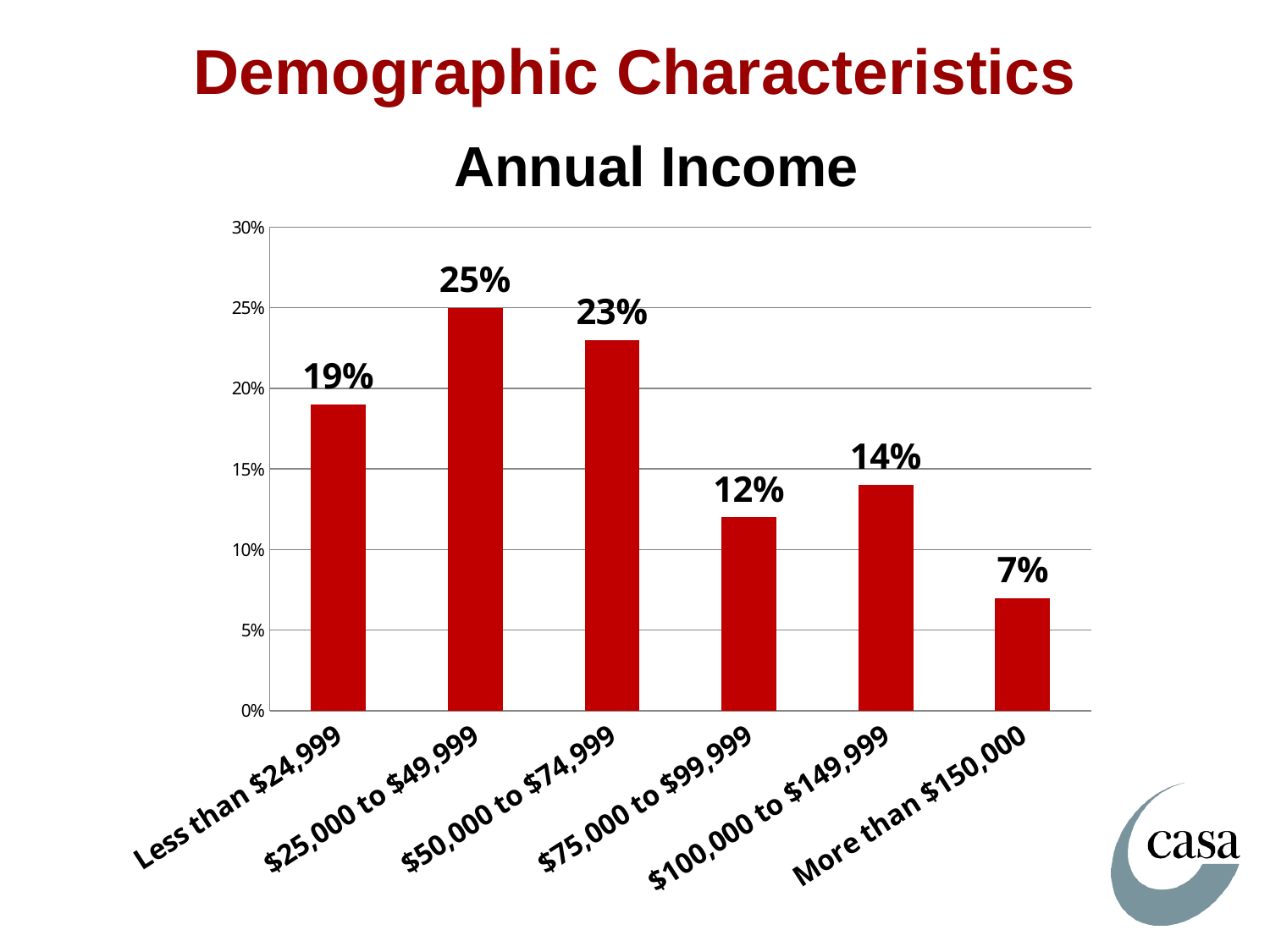
What percentage is shown for the More than $150,000 category? 7% What percentage of respondents have an annual income of less than $24,999? 19% What is the title of the chart? Annual Income Which income category has the lowest percentage? More than $150,000 What is the value shown for the $75,000 to $99,999 income category? 12% How much larger is the Less than $24,999 share than the More than $150,000 share? 12% How many income categories are shown on the chart? 6 What type of chart is used to show annual income? Bar chart Which is larger: the value for $75,000 to $99,999 or the value for $100,000 to $149,999? $100,000 to $149,999 Is the value for $50,000 to $74,999 greater or less than 20%? greater Which income category has the highest percentage? $25,000 to $49,999 What is the difference between the $25,000 to $49,999 and $50,000 to $74,999 categories? 2%